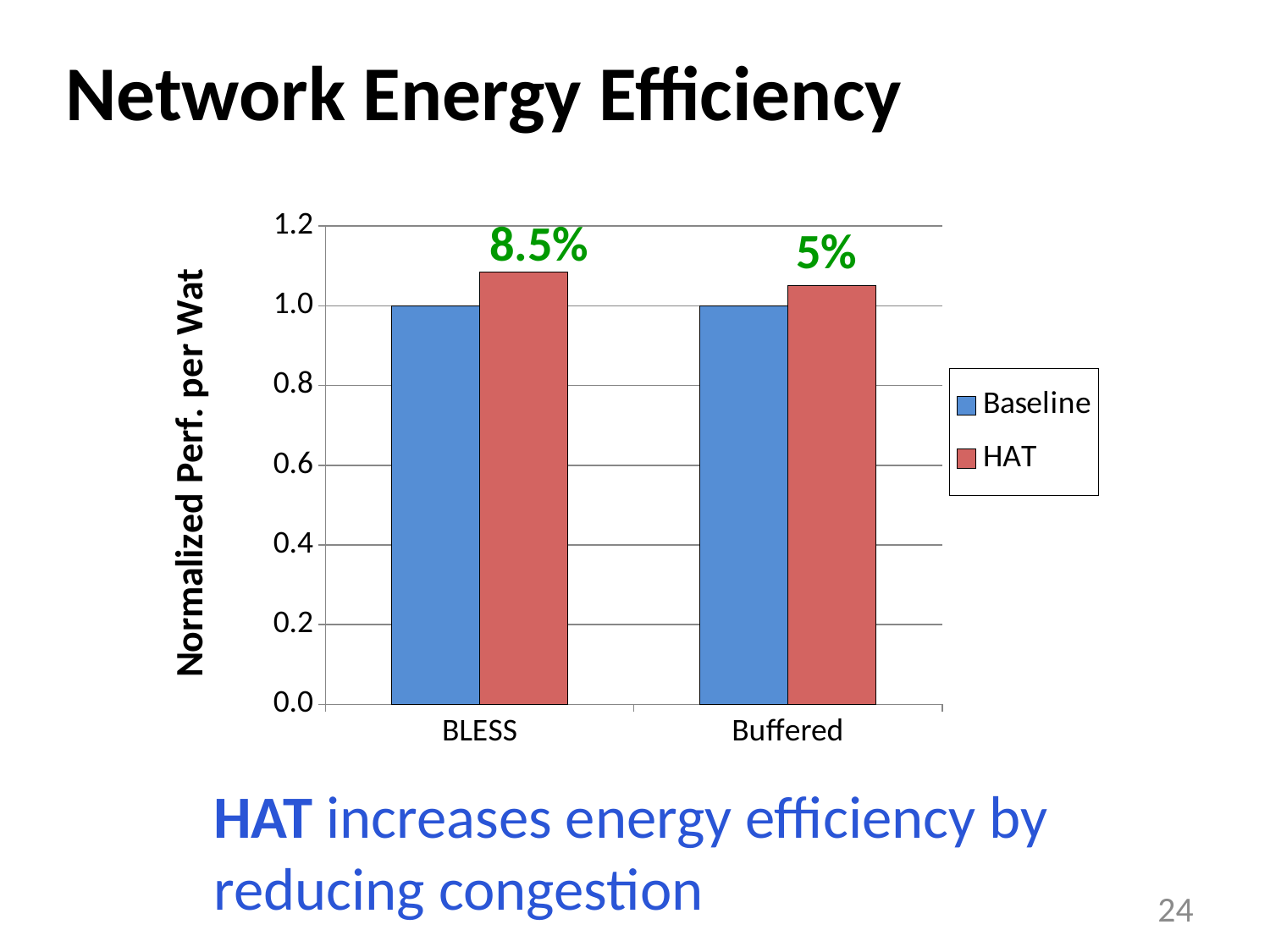
How many series does the legend list? 2 For BLESS, which series has the larger value, Baseline or HAT? HAT Which category has the higher HAT value, BLESS or Buffered? BLESS Which series is drawn in red? HAT What is the y-axis label of the chart? Normalized Perf. per Wat What is the Baseline value for BLESS? 1.0 How many categories are shown on the x axis? 2 What is the Baseline value for Buffered? 1.0 Is the HAT value for Buffered greater or less than 1.2? less What kind of chart is shown on the slide? bar chart Is the HAT value for BLESS greater or less than 1.0? greater What percentage improvement is annotated above the BLESS bars? 8.5%